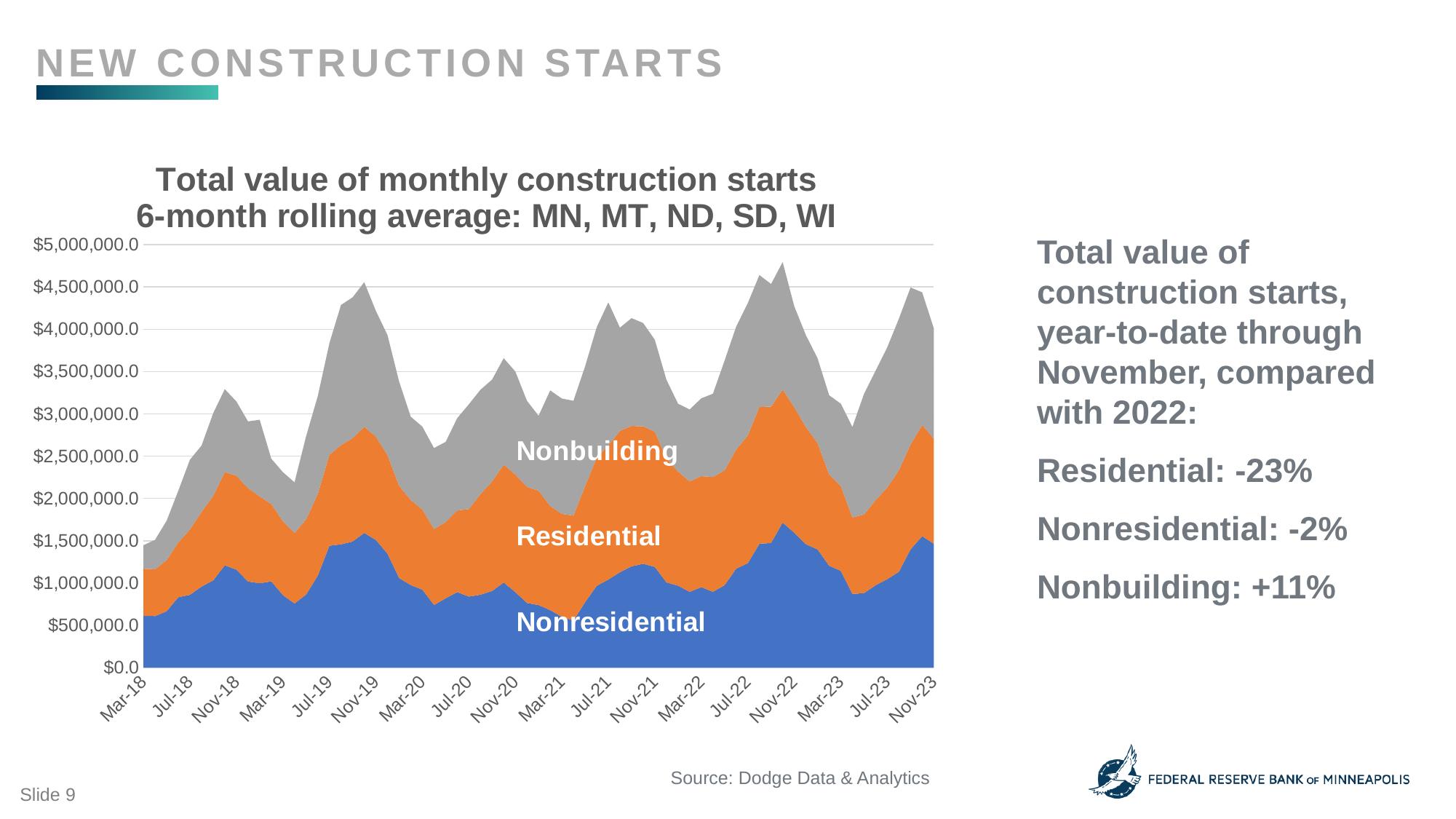
What are the three series labeled in the chart? Nonbuilding, Residential, Nonresidential Is the total stacked value at Mar-18 greater or less than $2,000,000.0? less Is the total stacked value at Nov-22 greater or less than $4,500,000.0? less Which series is plotted at the bottom of the stack? Nonresidential Does the total stacked value rise or fall from Mar-18 to Nov-18? Rise What kind of chart is shown on the slide? Stacked area chart Is the Nonresidential value at Mar-21 greater or less than $1,000,000.0? less Is the highest total peak in the chart reached in 2022 or in 2019? 2022 How many series are plotted in the chart? 3 How many month labels are shown on the x axis? 18